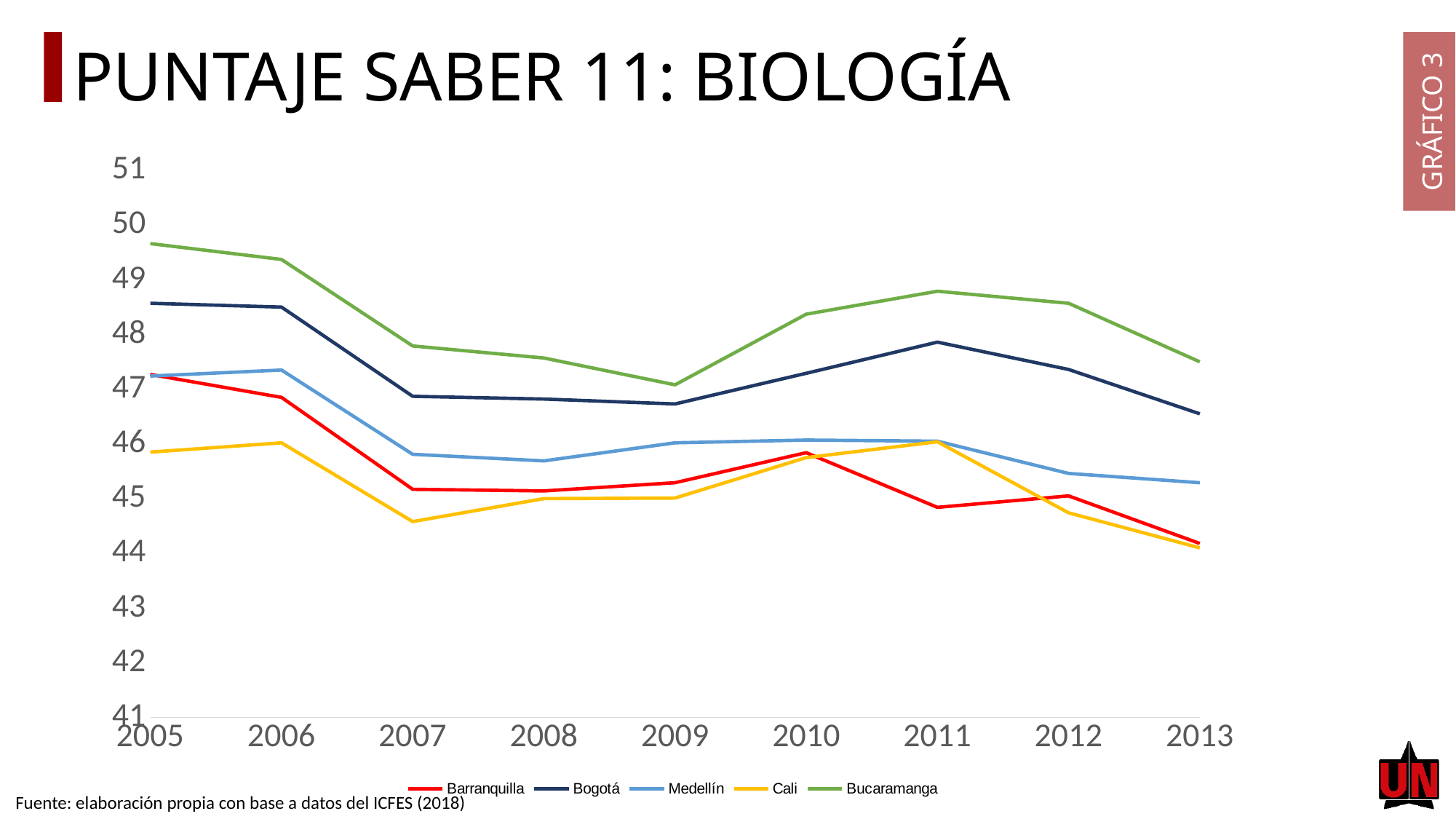
In 2011, which is larger: the value for Bogotá or the value for Medellín? Bogotá What is the title of the chart? PUNTAJE SABER 11: BIOLOGÍA Is the value for Bucaramanga in 2005 greater or less than 49? greater Is the value for Cali in 2007 greater or less than 45? less Which city has the highest score in 2005? Bucaramanga What kind of chart is shown on the slide? line chart Is the value for Bogotá in 2013 greater or less than 46? greater Does the Bogotá line rise or fall from 2011 to 2013? fall How many series does the legend list? 5 Which city has the lowest score in 2007? Cali Which city has the lowest score in 2011? Barranquilla How many years are shown on the x axis? 9